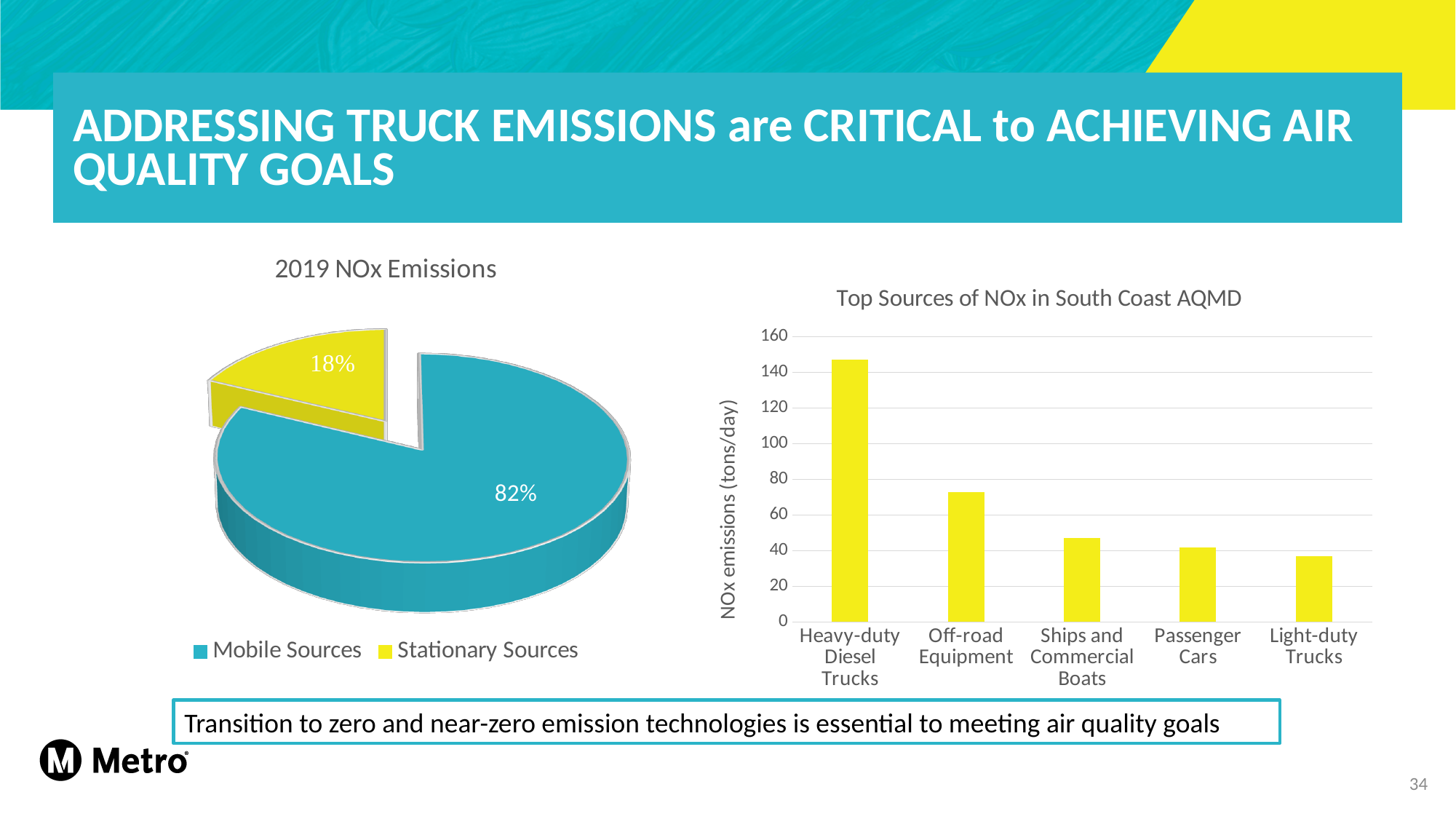
In the pie chart titled '2019 NOx Emissions', how many entries does the legend list? 2 What kind of chart is 'Top Sources of NOx in South Coast AQMD'? Bar chart In the chart 'Top Sources of NOx in South Coast AQMD', is the value for Heavy-duty Diesel Trucks greater or less than 140? greater In the pie chart titled '2019 NOx Emissions', how many percentage points larger is Mobile Sources than Stationary Sources? 64 In the pie chart titled '2019 NOx Emissions', what share is Stationary Sources? 18% In the chart 'Top Sources of NOx in South Coast AQMD', which source has the highest NOx emissions? Heavy-duty Diesel Trucks In the chart 'Top Sources of NOx in South Coast AQMD', which source has the lowest NOx emissions? Light-duty Trucks In the pie chart titled '2019 NOx Emissions', what share is Mobile Sources? 82% In the chart 'Top Sources of NOx in South Coast AQMD', how many source categories are shown? 5 In the chart 'Top Sources of NOx in South Coast AQMD', is the value for Off-road Equipment greater or less than 80? less In the pie chart titled '2019 NOx Emissions', which slice is larger, Mobile Sources or Stationary Sources? Mobile Sources What kind of chart is the chart on the left of the slide? Pie chart